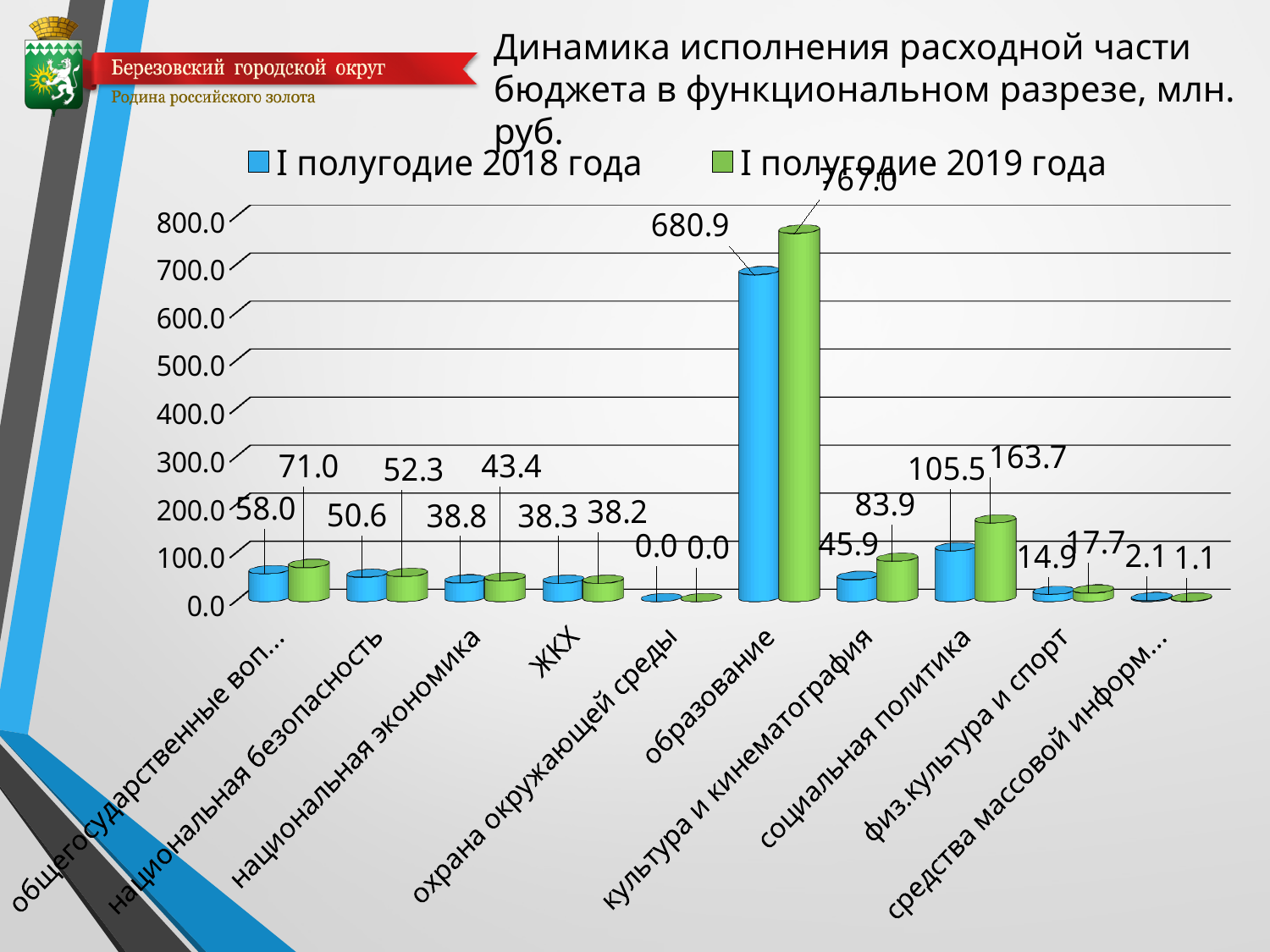
What kind of chart is shown on the slide? bar chart What is the value for ЖКХ in I полугодие 2018 года? 38.3 What is the value for культура и кинематография in I полугодие 2019 года? 83.9 What is the difference between the I полугодие 2019 года and I полугодие 2018 года values for образование? 86.1 How many categories are shown on the x axis? 10 What is the value for образование in I полугодие 2019 года? 767.0 Which is larger for физ.культура и спорт: the I полугодие 2018 года value or the I полугодие 2019 года value? I полугодие 2019 года What is the value for социальная политика in I полугодие 2018 года? 105.5 Which category has the highest value in I полугодие 2019 года? образование What is the difference between the I полугодие 2019 года and I полугодие 2018 года values for социальная политика? 58.2 How many series does the legend list? 2 Which category has the lowest value in I полугодие 2018 года? охрана окружающей среды